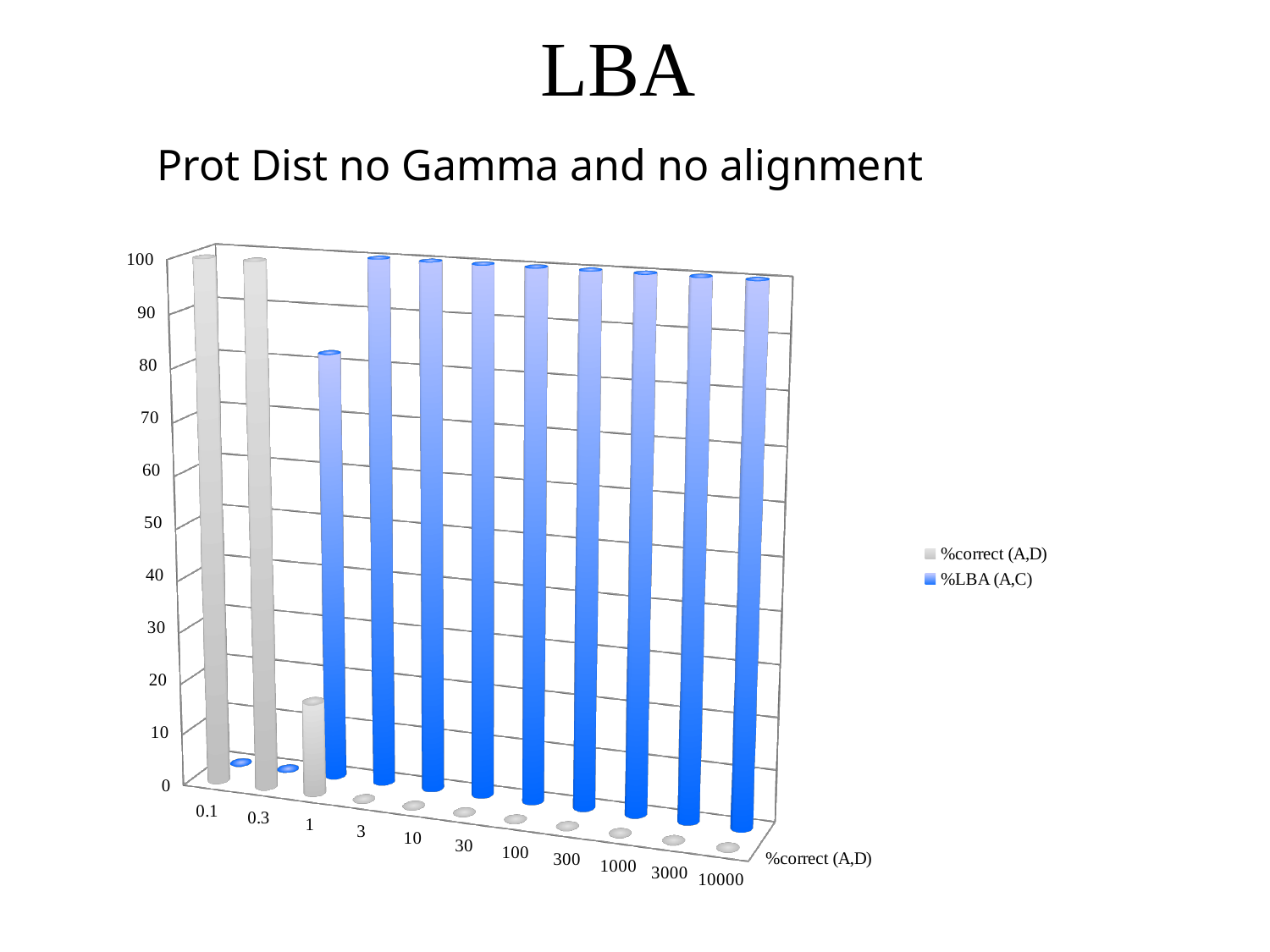
How many series does the legend list? 2 At category 1, which series has the larger value, %correct (A,D) or %LBA (A,C)? %LBA (A,C) Is the %correct (A,D) value at 0.1 greater or less than 90? greater Do the %correct (A,D) values rise or fall as you move from 0.1 to 10000 along the x axis? fall At category 0.1, which series has the larger value, %correct (A,D) or %LBA (A,C)? %correct (A,D) Which series is drawn in blue? %LBA (A,C) Is the %LBA (A,C) value at 3 greater or less than 90? greater Is the %LBA (A,C) value at 0.1 greater or less than 10? less How many categories are shown along the x axis? 11 What is the title shown above the chart? Prot Dist no Gamma and no alignment What kind of chart is shown on the slide? bar chart